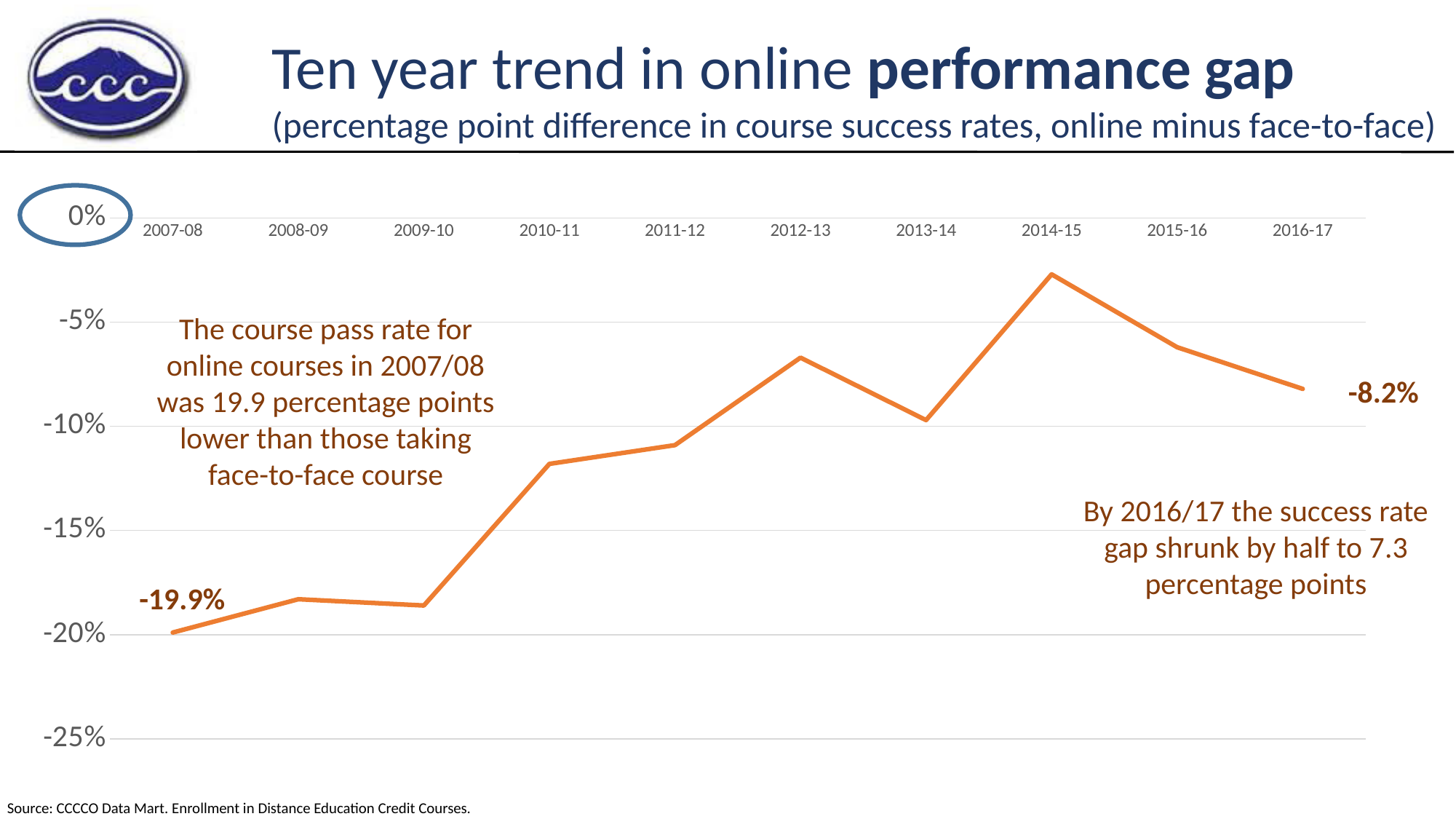
Which is larger, the value for 2013-14 or the value for 2014-15? 2014-15 Which year has the lowest value? 2007-08 Is the value for 2009-10 greater or less than -15%? less How many academic years are plotted on the chart? 10 Do the values generally rise or fall from 2007-08 to 2016-17? rise What kind of chart is shown on the slide? line chart What is the value for 2016-17? -8.2% By how many percentage points did the value change between 2007-08 and 2016-17? 11.7 percentage points Is the value for 2010-11 greater or less than -10%? less Which year has the highest value (closest to 0%)? 2014-15 Is the value for 2014-15 greater or less than -5%? greater What is the value for 2007-08? -19.9%